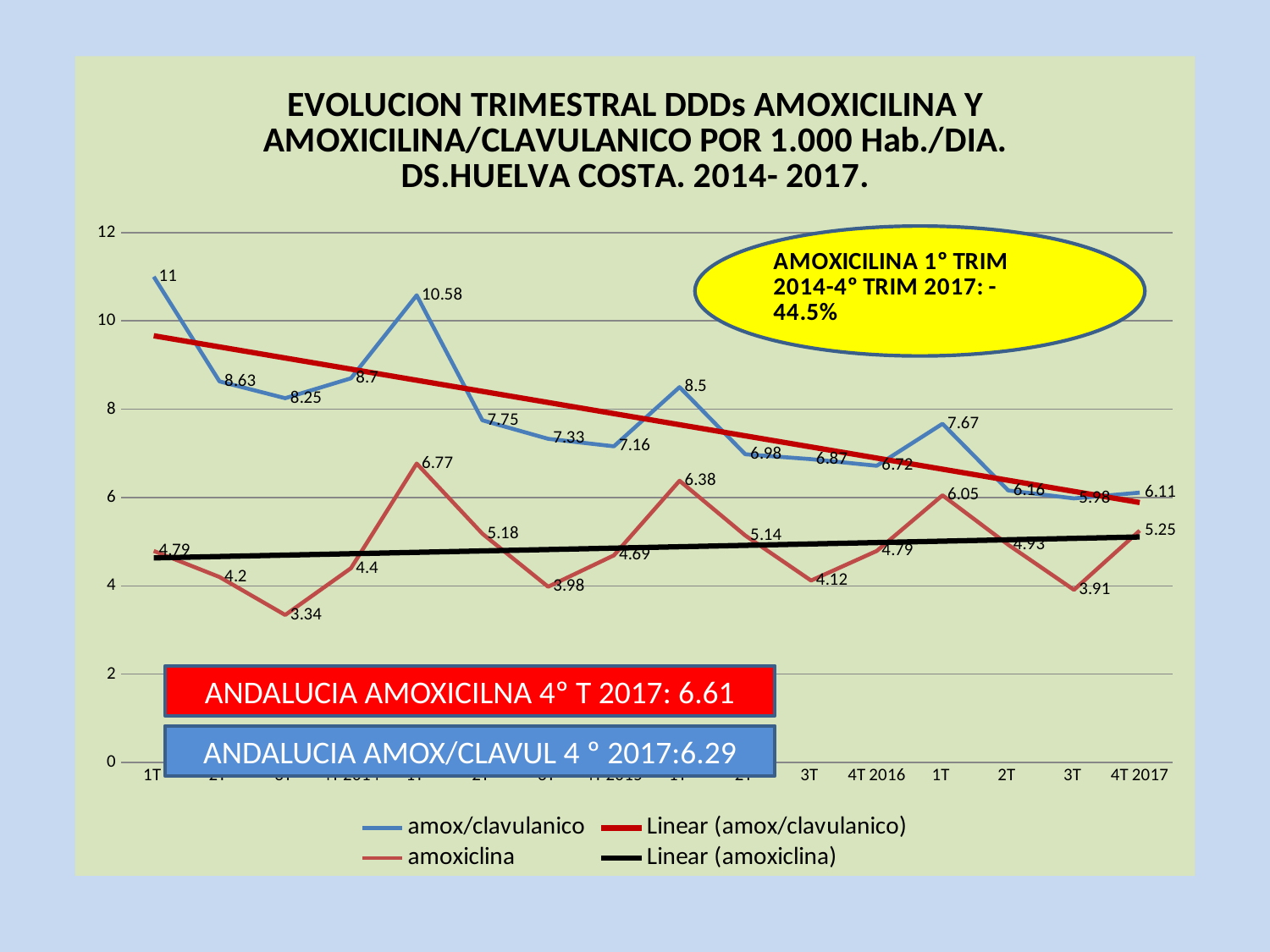
Does the amox/clavulanico series generally rise or fall from 1T 2014 to 4T 2017? fall What is the highest value plotted for the amoxiclina series? 6.77 What is the amox/clavulanico value at 1T 2017? 7.67 What kind of chart is shown on the slide? line chart What is the amoxiclina value at 4T 2017? 5.25 What is the amox/clavulanico value at 4T 2017? 6.11 What is the highest value plotted for the amox/clavulanico series? 11 At 4T 2017, which series has the higher value, amox/clavulanico or amoxiclina? amox/clavulanico How many entries does the chart legend list? 4 What is the lowest value plotted for the amoxiclina series? 3.34 What percentage change is stated in the yellow oval for amoxicilina from 1° trim 2014 to 4° trim 2017? -44.5% What is the difference between the amox/clavulanico values at 4T 2016 and 4T 2017? 0.61